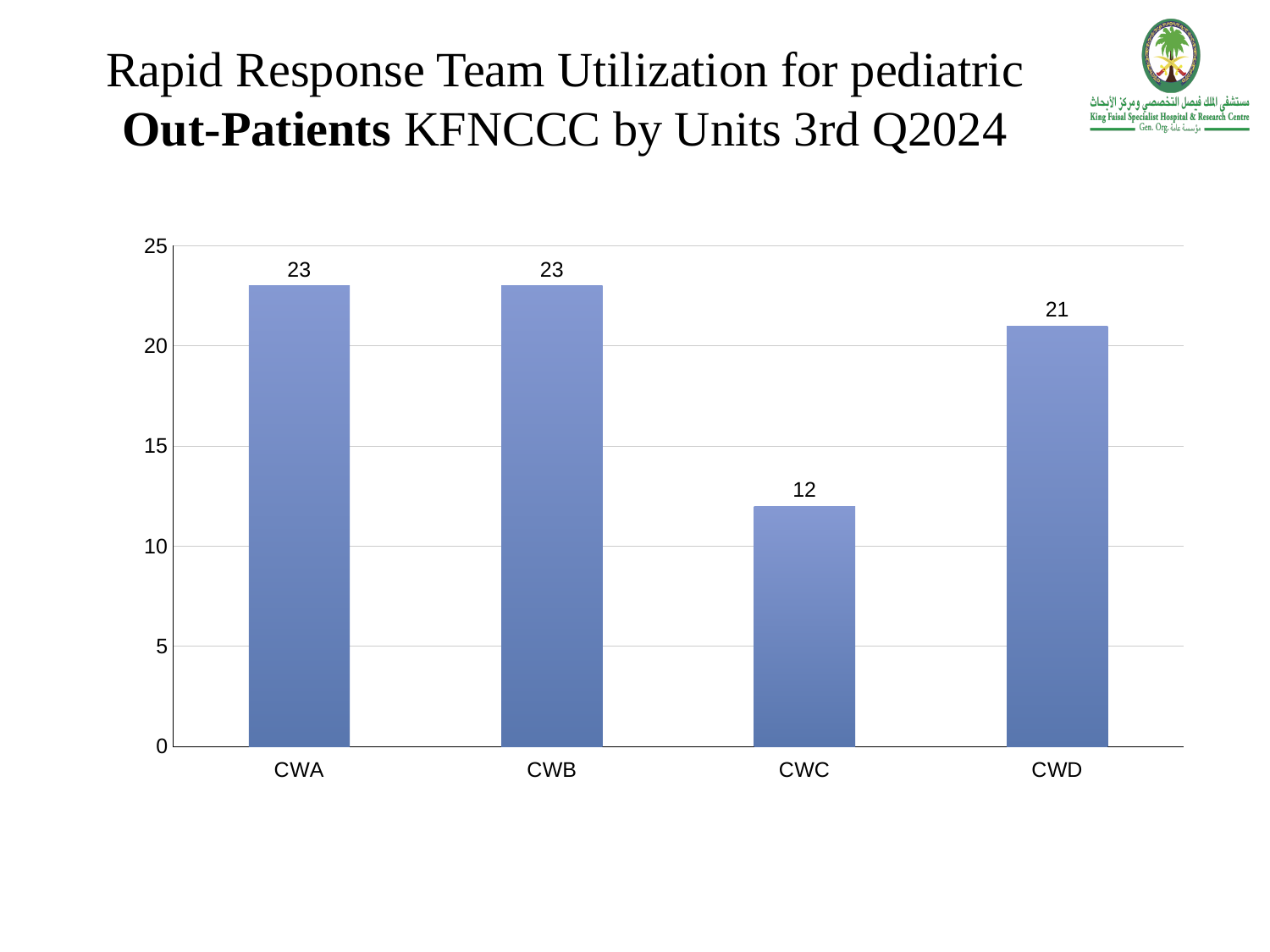
Which is larger, the value for CWD or the value for CWC? CWD Is the value for CWD greater or less than 20? greater What is the value for CWD? 21 What is the value for CWC? 12 What is the difference between the values for CWB and CWC? 11 Which unit has the lowest value? CWC What is the highest value shown on the vertical axis? 25 Is the value for CWC greater or less than 15? less What is the difference between the values for CWA and CWD? 2 What kind of chart is shown on the slide? bar chart What is the value for CWA? 23 How many units are shown on the chart? 4